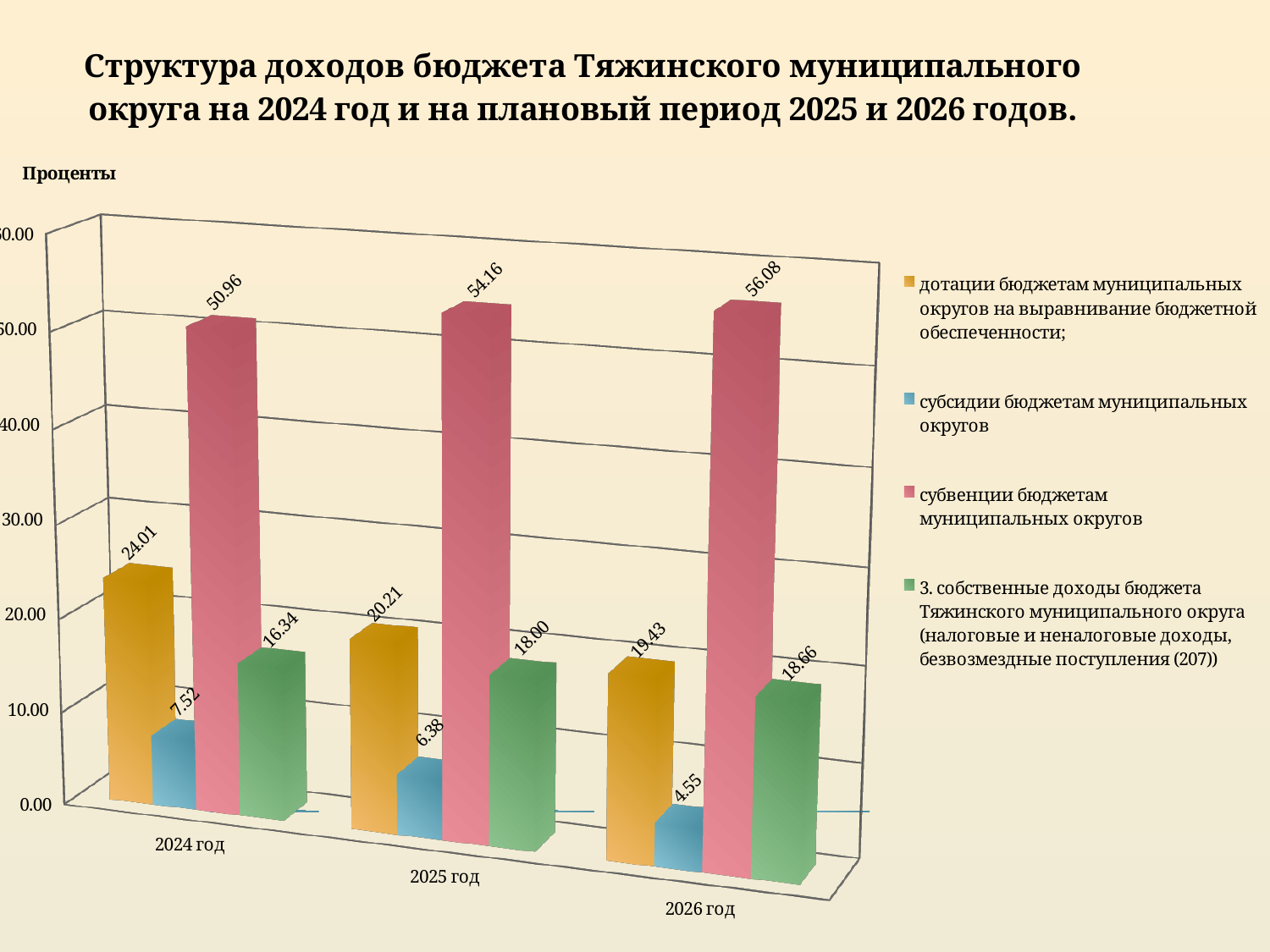
Which is larger in 2025 год: дотации бюджетам муниципальных округов на выравнивание бюджетной обеспеченности or собственные доходы бюджета? дотации бюджетам муниципальных округов на выравнивание бюджетной обеспеченности What is the value for субсидии бюджетам муниципальных округов in 2026 год? 4.55 Which year has the lowest value for субсидии бюджетам муниципальных округов? 2026 год How many series does the legend list? 4 What is the value for дотации бюджетам муниципальных округов на выравнивание бюджетной обеспеченности in 2025 год? 20.21 What is the difference between the субвенции values for 2026 год and 2024 год? 5.12 Which year has the highest value for субвенции бюджетам муниципальных округов? 2026 год What kind of chart is shown on the slide? bar chart What is the value for субвенции бюджетам муниципальных округов in 2024 год? 50.96 How many years (categories) are shown on the x axis? 3 What is the value for собственные доходы бюджета Тяжинского муниципального округа in 2026 год? 18.66 Do the values for дотации бюджетам муниципальных округов на выравнивание бюджетной обеспеченности rise or fall from 2024 год to 2026 год? fall